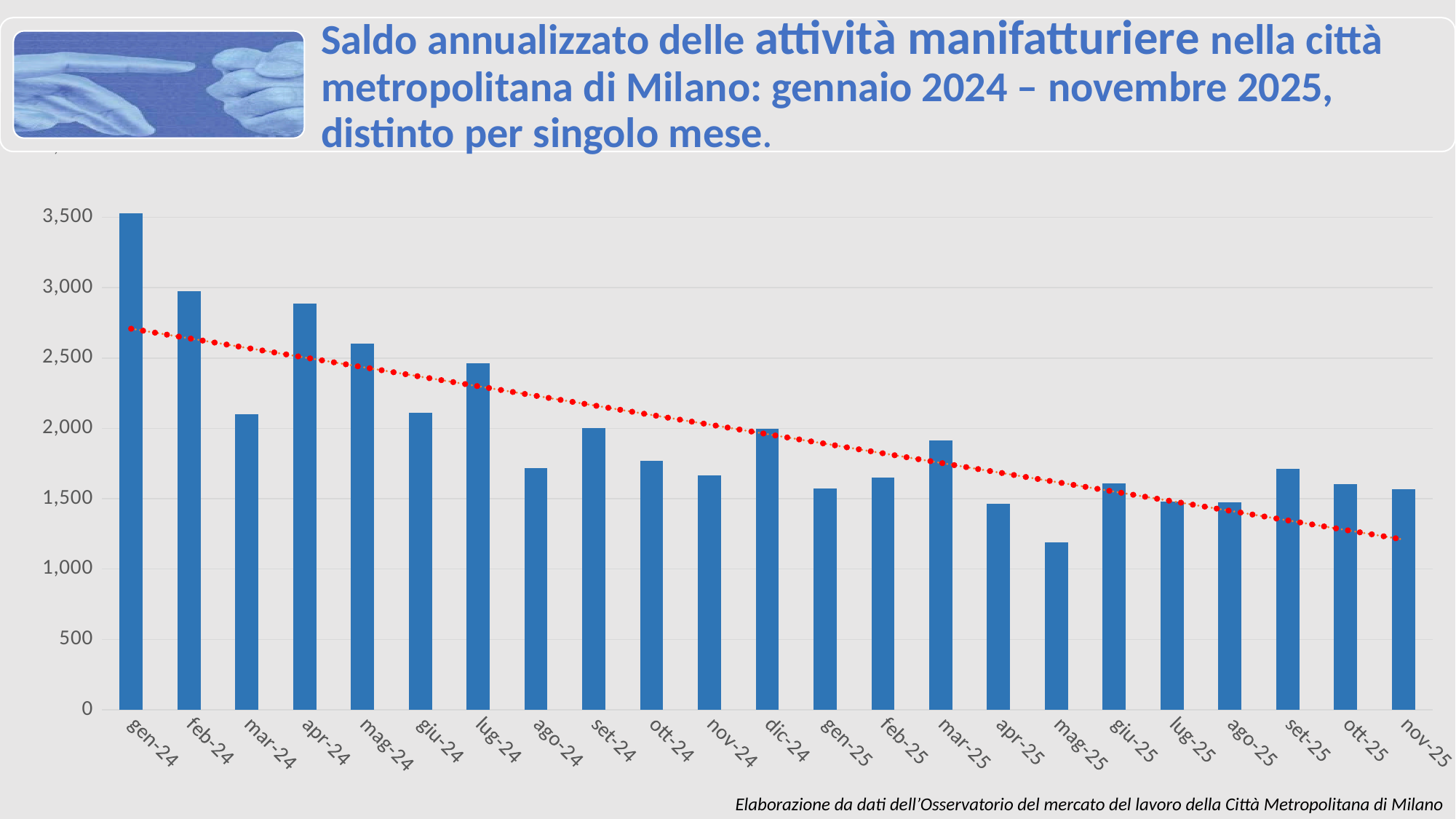
Which is larger, the value for feb-24 or the value for mar-24? feb-24 Is the value for ago-24 greater or less than 2,000? less Is the value for mag-25 greater or less than 1,500? less What colour is the dotted trend line drawn across the bars? red Which month has the highest value on the chart? gen-24 Is the value for apr-24 greater or less than 2,500? greater What kind of chart is shown on the slide? bar chart How many months (bars) are plotted on the chart? 23 Which is larger, the value for mar-25 or the value for apr-25? mar-25 Do the values generally rise or fall from gen-24 to nov-25? fall Which month has the lowest value on the chart? mag-25